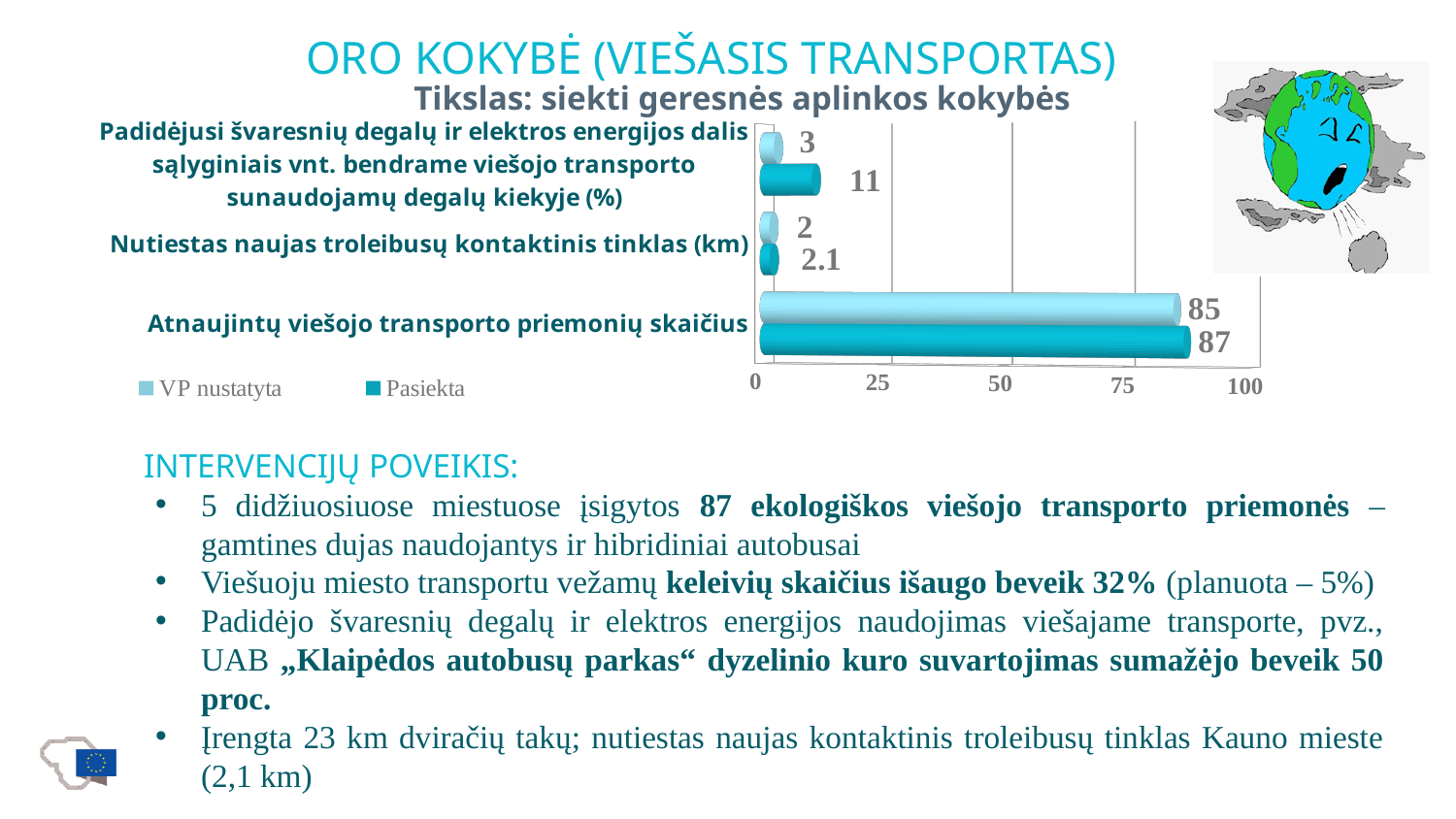
How many series does the chart legend list? 2 What is the "Pasiekta" value for the category about the share of cleaner fuels and electricity (%)? 11 What is the "VP nustatyta" value for "Atnaujintų viešojo transporto priemonių skaičius"? 85 What is the difference between the "Pasiekta" and "VP nustatyta" values for the share of cleaner fuels and electricity (%)? 8 What is the "Pasiekta" value for "Atnaujintų viešojo transporto priemonių skaičius"? 87 What is the "VP nustatyta" value for the category about the share of cleaner fuels and electricity (%)? 3 How many categories are shown in the chart? 3 Which category has the lowest "VP nustatyta" value? Nutiestas naujas troleibusų kontaktinis tinklas (km) What is the "Pasiekta" value for "Nutiestas naujas troleibusų kontaktinis tinklas (km)"? 2.1 What type of chart is shown on the slide? Bar chart For "Atnaujintų viešojo transporto priemonių skaičius", which is larger: "VP nustatyta" or "Pasiekta"? Pasiekta Which category has the highest "Pasiekta" value? Atnaujintų viešojo transporto priemonių skaičius